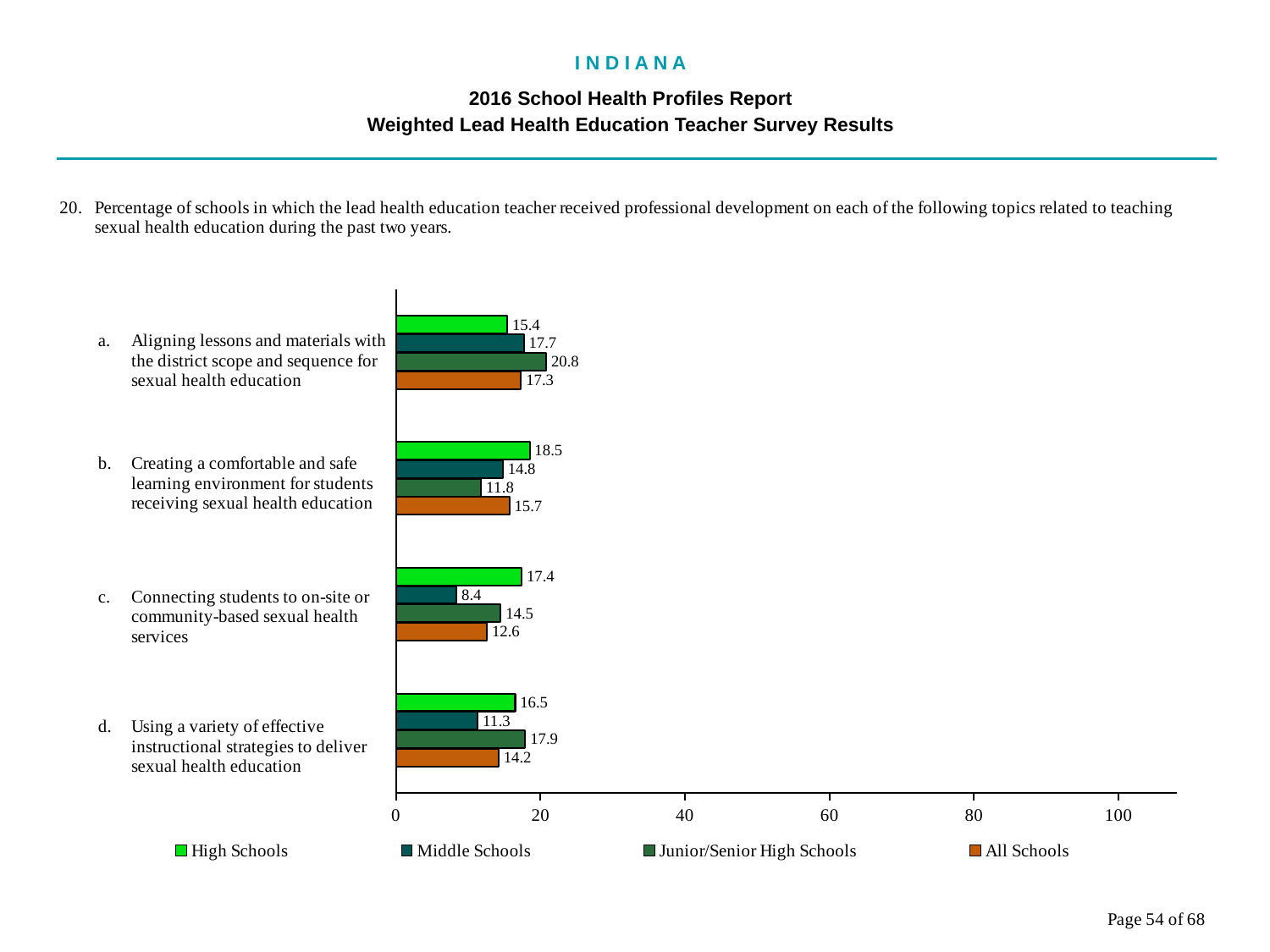
For topic d, which is larger: the High Schools value or the Junior/Senior High Schools value? Junior/Senior High Schools What is the difference between the High Schools and Middle Schools values for topic c? 9.0 How many topics (categories) are shown in the chart? 4 How many series does the legend list? 4 Which topic has the lowest value for Middle Schools? c. Connecting students to on-site or community-based sexual health services What is the value for All Schools for topic d (Using a variety of effective instructional strategies to deliver sexual health education)? 14.2 What is the value for High Schools for topic a (Aligning lessons and materials with the district scope and sequence for sexual health education)? 15.4 What kind of chart is shown on the slide? Bar chart What is the value for Junior/Senior High Schools for topic b (Creating a comfortable and safe learning environment for students receiving sexual health education)? 11.8 Which topic has the highest value for Junior/Senior High Schools? a. Aligning lessons and materials with the district scope and sequence for sexual health education What is the value for Middle Schools for topic c (Connecting students to on-site or community-based sexual health services)? 8.4 Is the value for Junior/Senior High Schools for topic a greater or less than 20? greater